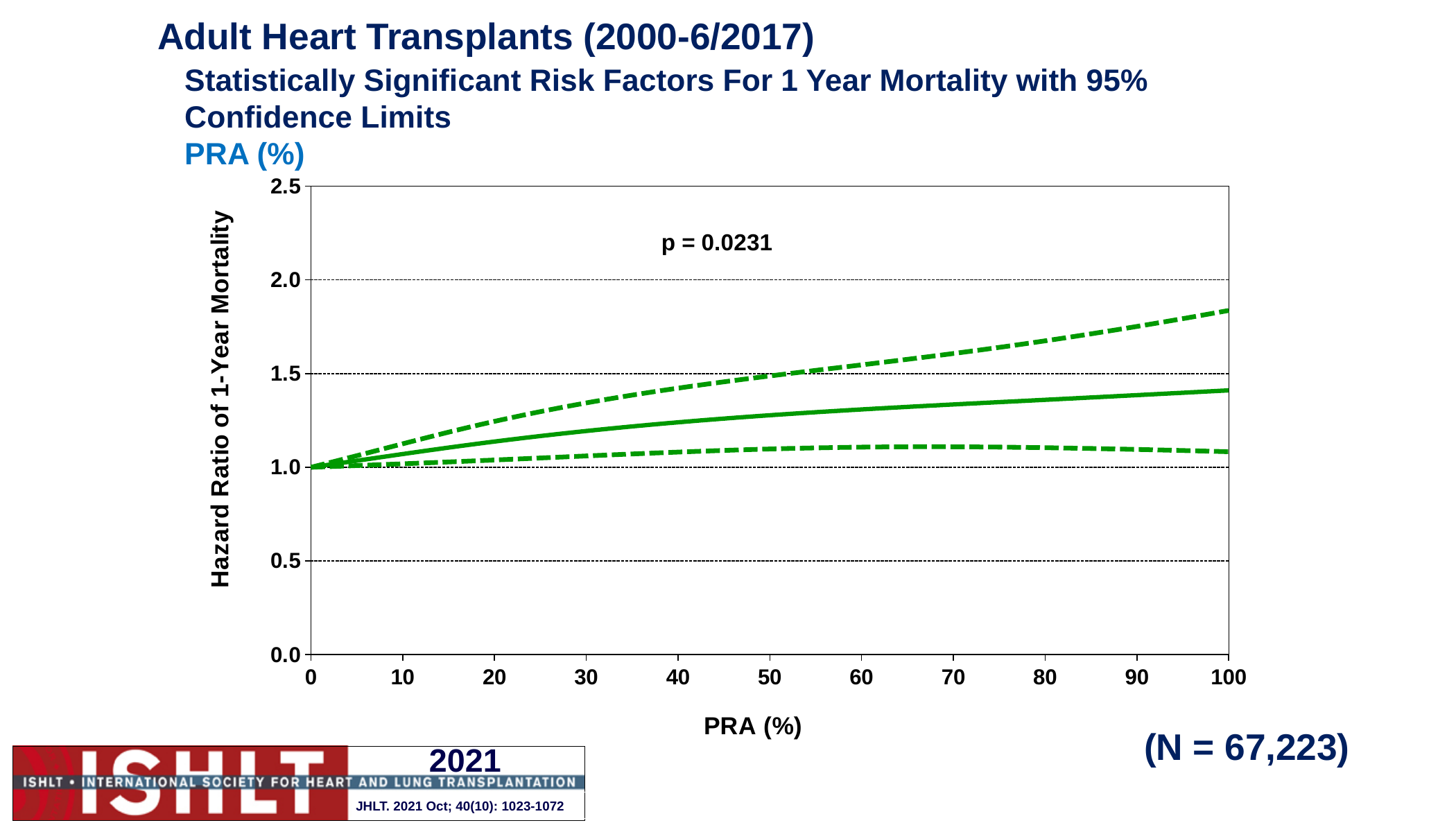
Is the hazard ratio (solid line) at PRA 100% greater or less than 1.0? greater Does the solid hazard ratio line rise or fall as PRA (%) increases from 0 to 100? rises Is the upper 95% confidence limit (upper dashed line) at PRA 100% greater or less than 1.5? greater What p-value is shown on the chart? p = 0.0231 How many lines are plotted on the chart? 3 Is the lower 95% confidence limit (lower dashed line) at PRA 100% greater or less than 1.5? less What is the hazard ratio of 1-year mortality at PRA 0%? 1.0 What type of chart is shown on the slide? line chart What is the sample size (N) shown on the slide? N = 67,223